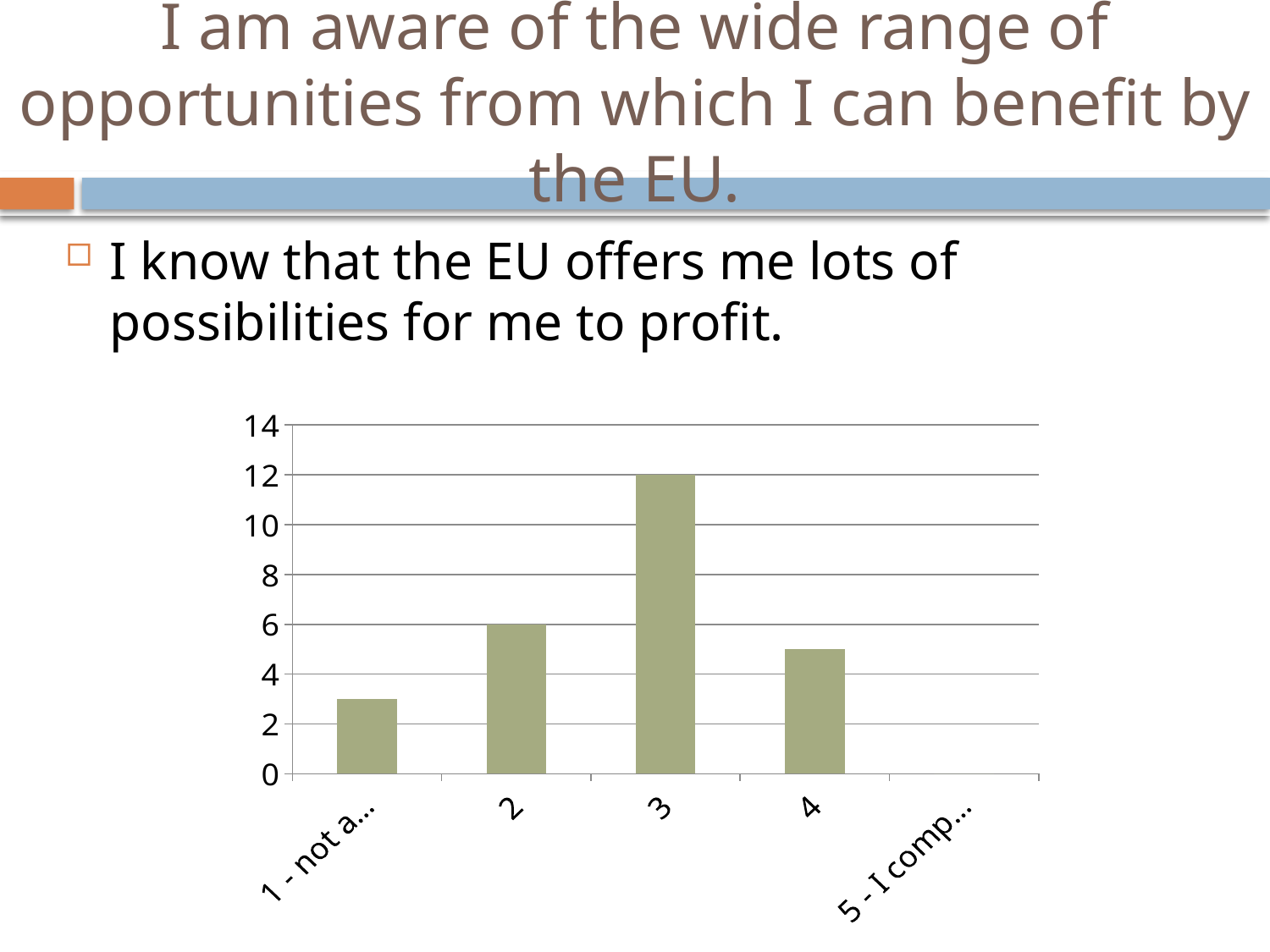
Is the value for category 4 greater or less than 6? less What is the value for category 2? 6 Is the value for category 4 greater or less than 4? greater Which has a larger value, category 2 or category 4? 2 How many categories are shown on the x axis of the chart? 5 Is the value for the first category (1 - not a...) greater or less than 4? less Which category has the highest value? 3 What is the difference between the values for category 3 and category 2? 6 What type of chart is shown on the slide? bar chart What is the highest value shown on the vertical axis of the chart? 14 What is the value for category 3? 12